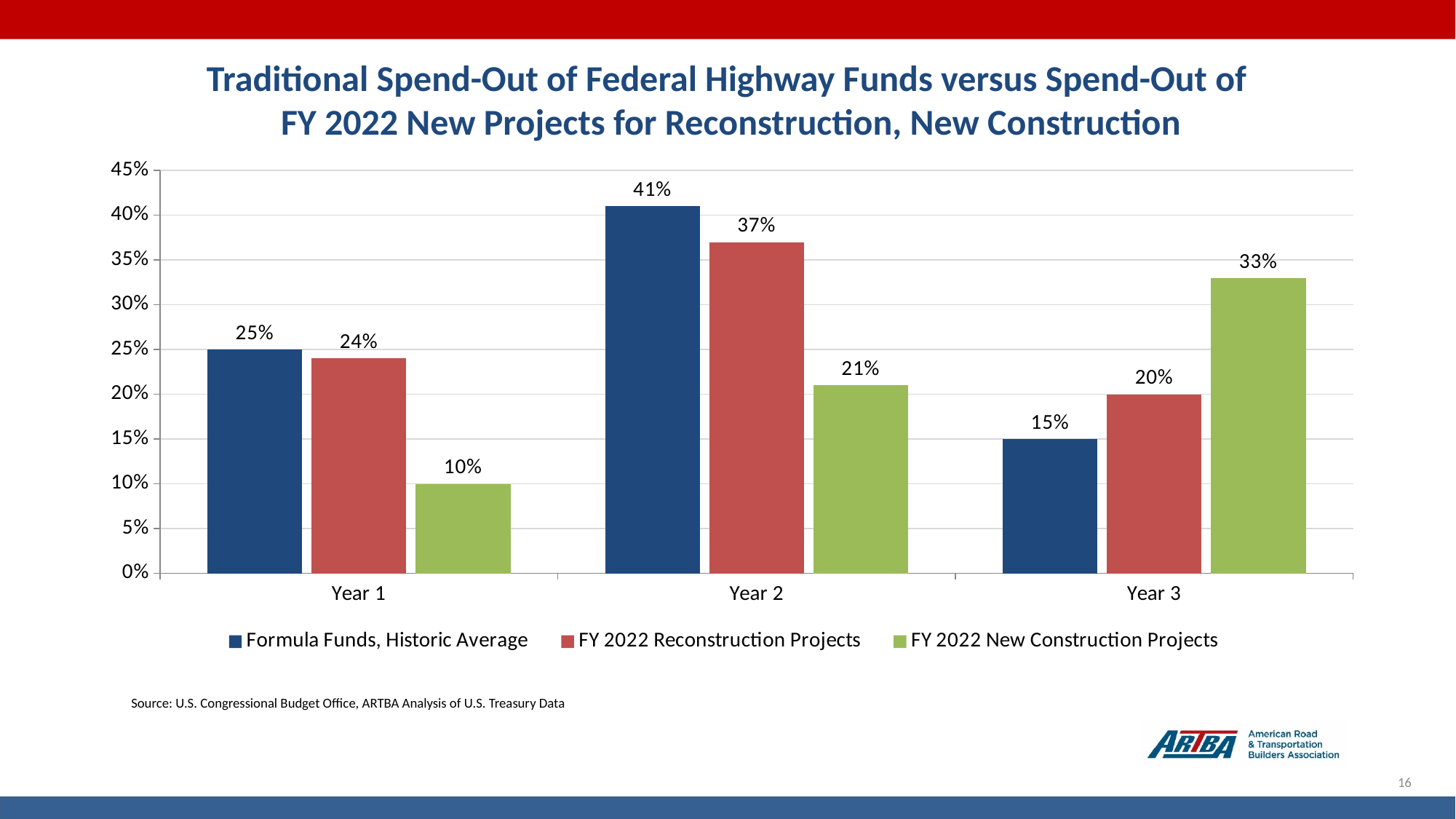
What colour represents FY 2022 Reconstruction Projects in the chart? Red How many series does the legend list? 3 Does the value for FY 2022 New Construction Projects rise or fall from Year 1 to Year 3? Rise In which year is the value for Formula Funds, Historic Average lowest? Year 3 What is the value for Formula Funds, Historic Average in Year 2? 41% What is the value for FY 2022 Reconstruction Projects in Year 3? 20% Which is larger in Year 3: FY 2022 Reconstruction Projects or FY 2022 New Construction Projects? FY 2022 New Construction Projects In which year is the value for FY 2022 New Construction Projects highest? Year 3 How many year categories are shown on the x axis? 3 What kind of chart is shown on the slide? Bar chart What is the value for FY 2022 New Construction Projects in Year 1? 10% What is the difference between Formula Funds, Historic Average and FY 2022 New Construction Projects in Year 2? 20%